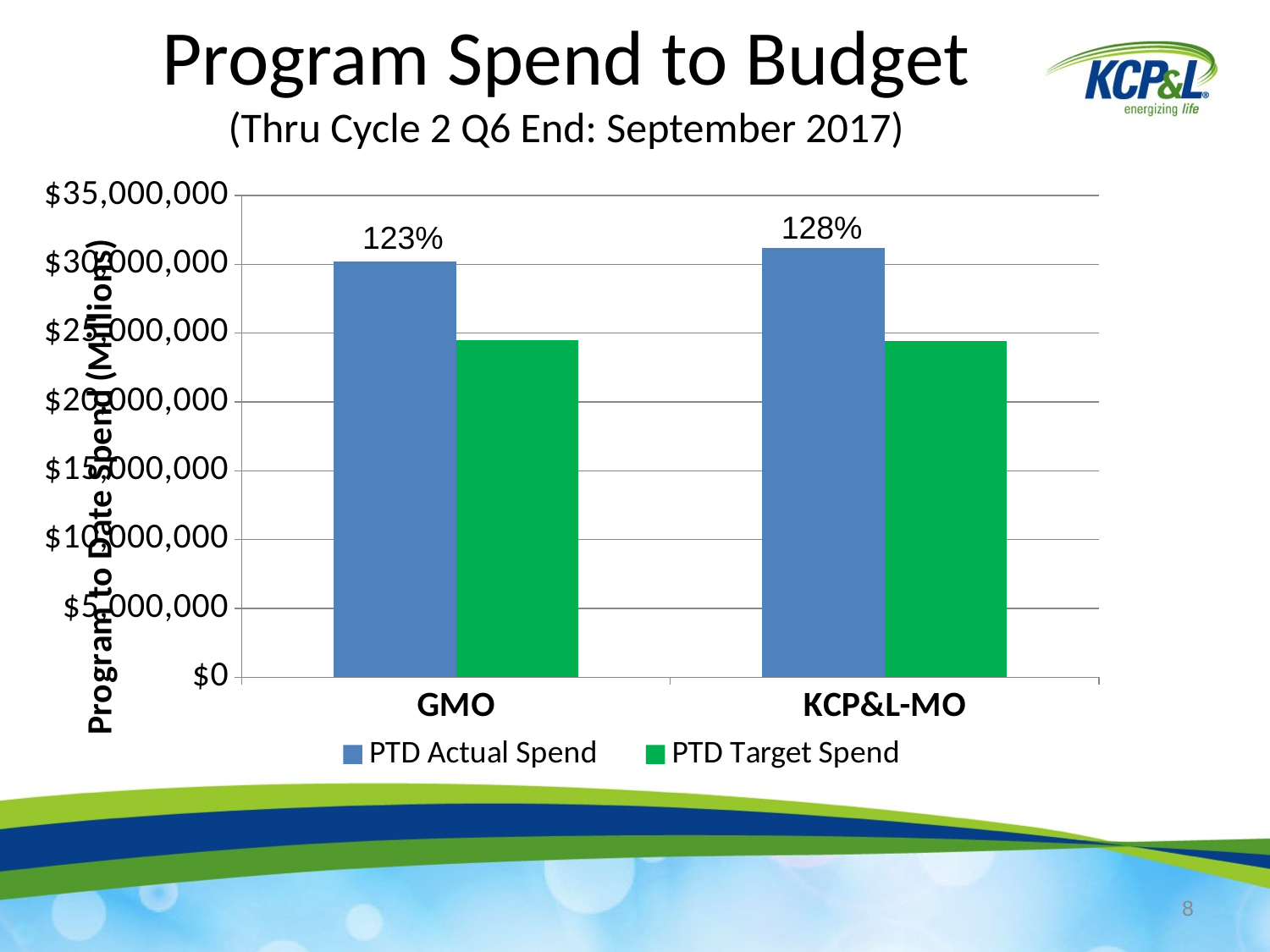
What kind of chart is shown on the slide? bar chart Is the PTD Actual Spend value for GMO greater or less than $25,000,000? greater How many series does the chart's legend list? 2 How many categories are shown on the x axis of the chart? 2 Is the PTD Target Spend value for KCP&L-MO greater or less than $20,000,000? greater For GMO, which bar is taller, PTD Actual Spend or PTD Target Spend? PTD Actual Spend What percentage label is shown above the PTD Actual Spend bar for GMO? 123% Is the PTD Target Spend value for GMO greater or less than $25,000,000? less What percentage label is shown above the PTD Actual Spend bar for KCP&L-MO? 128% What colour represents PTD Target Spend in the chart? green Which category has the higher PTD Actual Spend bar, GMO or KCP&L-MO? KCP&L-MO